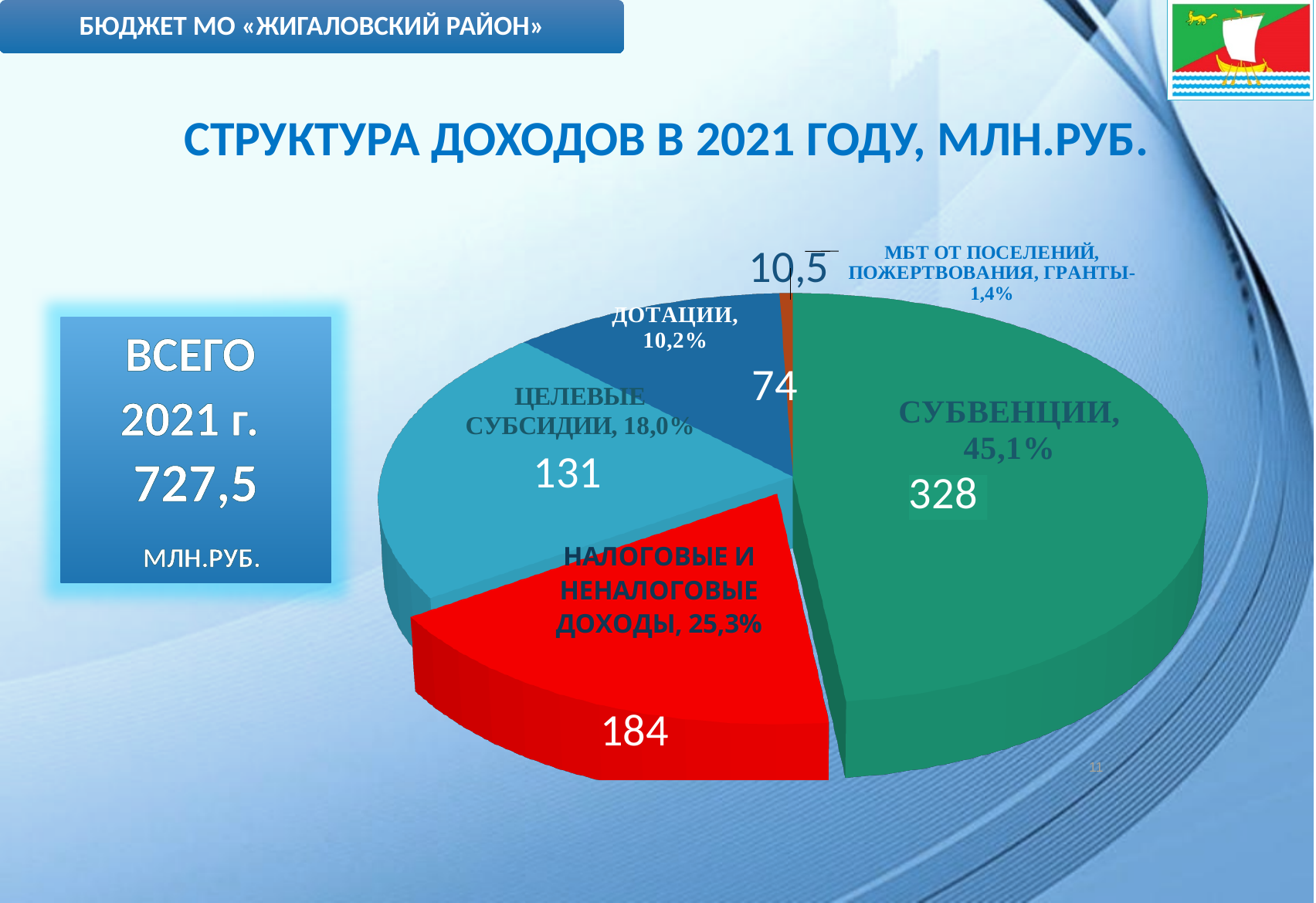
What share of the pie does СУБВЕНЦИИ represent? 45,1% What type of chart is shown on the slide? pie chart What is the value for ЦЕЛЕВЫЕ СУБСИДИИ in the pie chart? 131 What is the difference between the values for СУБВЕНЦИИ and НАЛОГОВЫЕ И НЕНАЛОГОВЫЕ ДОХОДЫ? 144 What share of the pie does ЦЕЛЕВЫЕ СУБСИДИИ represent? 18,0% Which category has the largest slice in the pie chart? СУБВЕНЦИИ What is the value for МБТ ОТ ПОСЕЛЕНИЙ, ПОЖЕРТВОВАНИЯ, ГРАНТЫ in the pie chart? 10,5 What is the value for НАЛОГОВЫЕ И НЕНАЛОГОВЫЕ ДОХОДЫ in the pie chart? 184 What is the value for СУБВЕНЦИИ in the pie chart? 328 What is the value for ДОТАЦИИ in the pie chart? 74 Which category has the smallest slice in the pie chart? МБТ ОТ ПОСЕЛЕНИЙ, ПОЖЕРТВОВАНИЯ, ГРАНТЫ How many slices does the pie chart have? 5